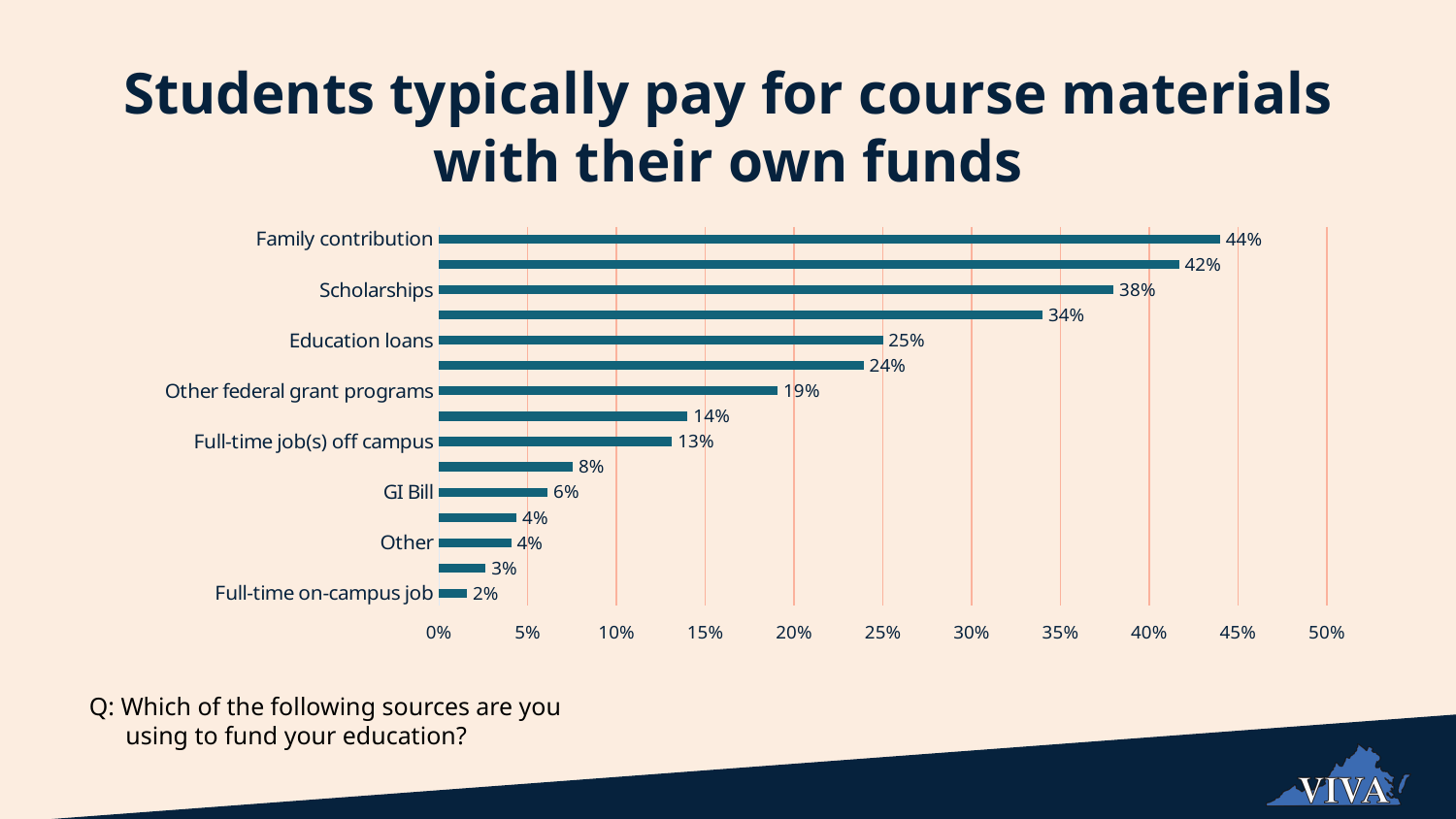
What is the difference between Family contribution and Scholarships? 6% What is the value for Other federal grant programs? 19% What is the title of the slide? Students typically pay for course materials with their own funds Is the value for Other federal grant programs greater or less than 20%? less What is the value for GI Bill? 6% What is the value for Education loans? 25% What kind of chart is shown on the slide? Bar chart Which is larger, Education loans or Full-time job(s) off campus? Education loans Which labeled funding source has the lowest value? Full-time on-campus job What is the value for Scholarships? 38% What percentage of students use family contribution to fund their education? 44% Which funding source has the highest value? Family contribution